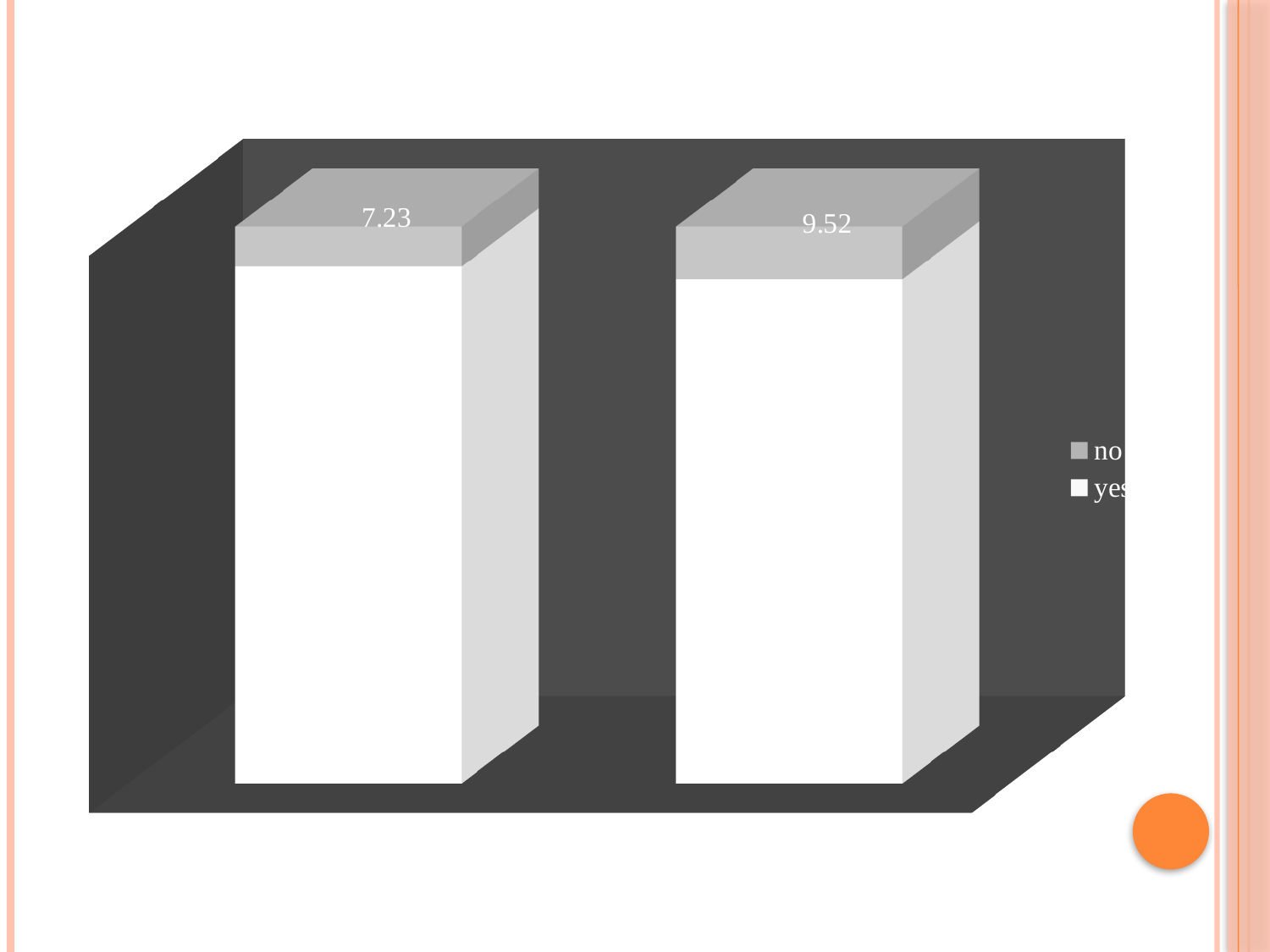
What value is printed on the right bar? 9.52 Is the printed value on the left bar greater or less than 8? less How many bars are plotted on the chart? 2 What value is printed on the left bar? 7.23 What kind of chart is shown on the slide? bar chart Which legend entry is shown in white? yes How many series does the legend list? 2 What are the two entries in the chart's legend? no and yes What is the difference between the printed values on the right bar and the left bar? 2.29 Is the printed value on the right bar greater or less than 9? greater Which bar has the larger printed value, the left bar or the right bar? the right bar